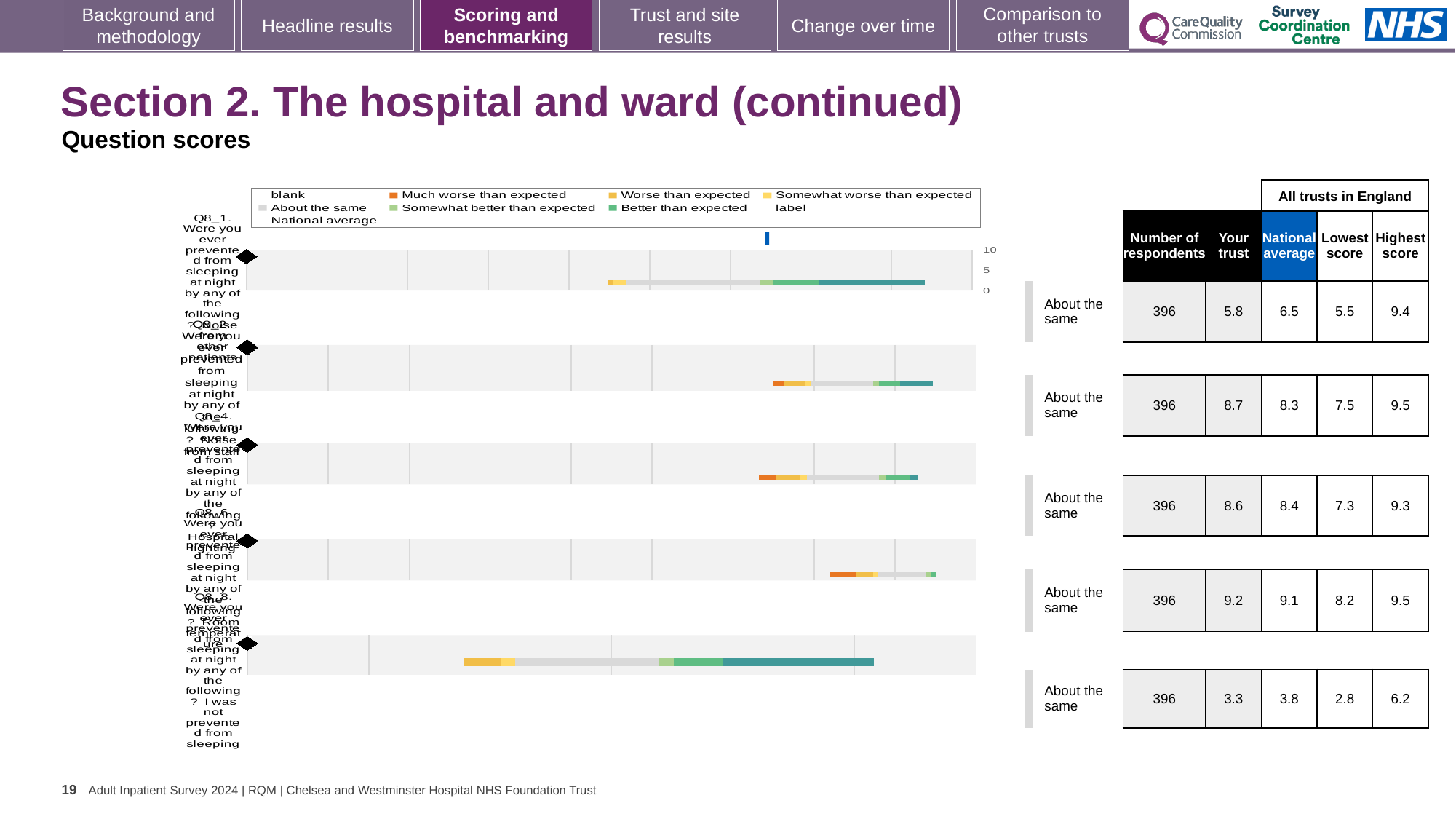
What benchmark label is shown next to each question row in the chart? About the same What is the national average for the last row (Q8_8)? 3.8 How many question rows (bars) are plotted in the chart? 5 For the first row (Q8_1), which is larger: the 'Your trust' score or the national average? National average What is the difference between the national average and the 'Your trust' score for the first row (Q8_1)? 0.7 What is the lowest score across all trusts in England for the third row (Q8_4)? 7.3 Which question row has the highest 'Your trust' score? Q8_6 How many respondents are listed for the fourth row (Q8_6)? 396 Which question row has the lowest 'Your trust' score? Q8_8 What is the 'Your trust' score for the first row (Q8_1)? 5.8 What kind of chart is shown on the slide? bar chart What is the highest score across all trusts in England for the second row (Q8_2)? 9.5